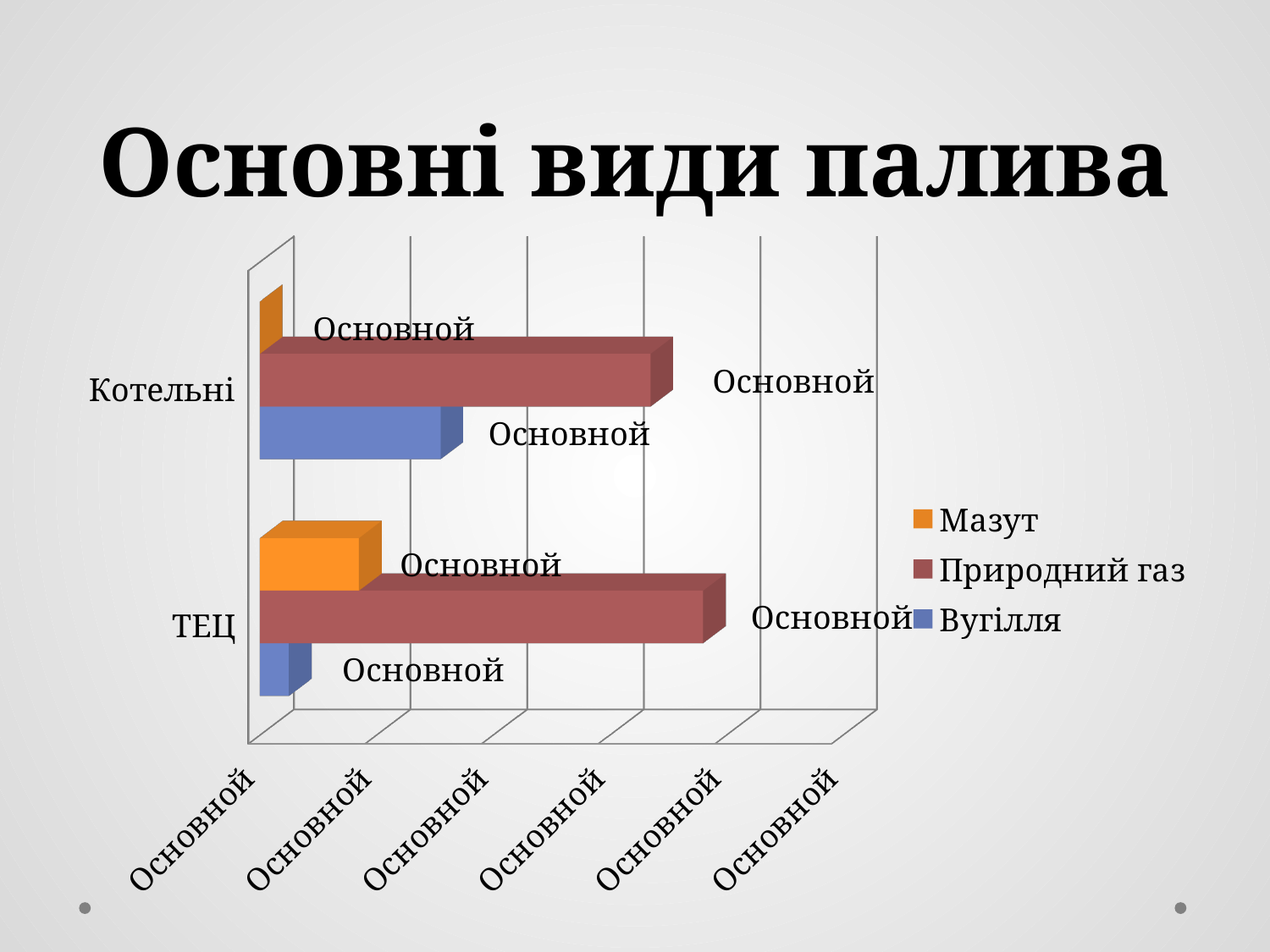
Which series has the longest bar for the category Котельні? Природний газ Which series has the shortest bar for the category ТЕЦ? Вугілля What kind of chart is shown on the slide? bar chart Which series is shown in orange in the legend? Мазут For the series Мазут, which category has the larger value, Котельні or ТЕЦ? ТЕЦ For the series Вугілля, which category has the larger value, Котельні or ТЕЦ? Котельні How many series does the legend list? 3 Which series has the shortest bar for the category Котельні? Мазут How many categories are shown on the vertical axis of the chart? 2 What is the title of the chart on the slide? Основні види палива Which series has the longest bar for the category ТЕЦ? Природний газ